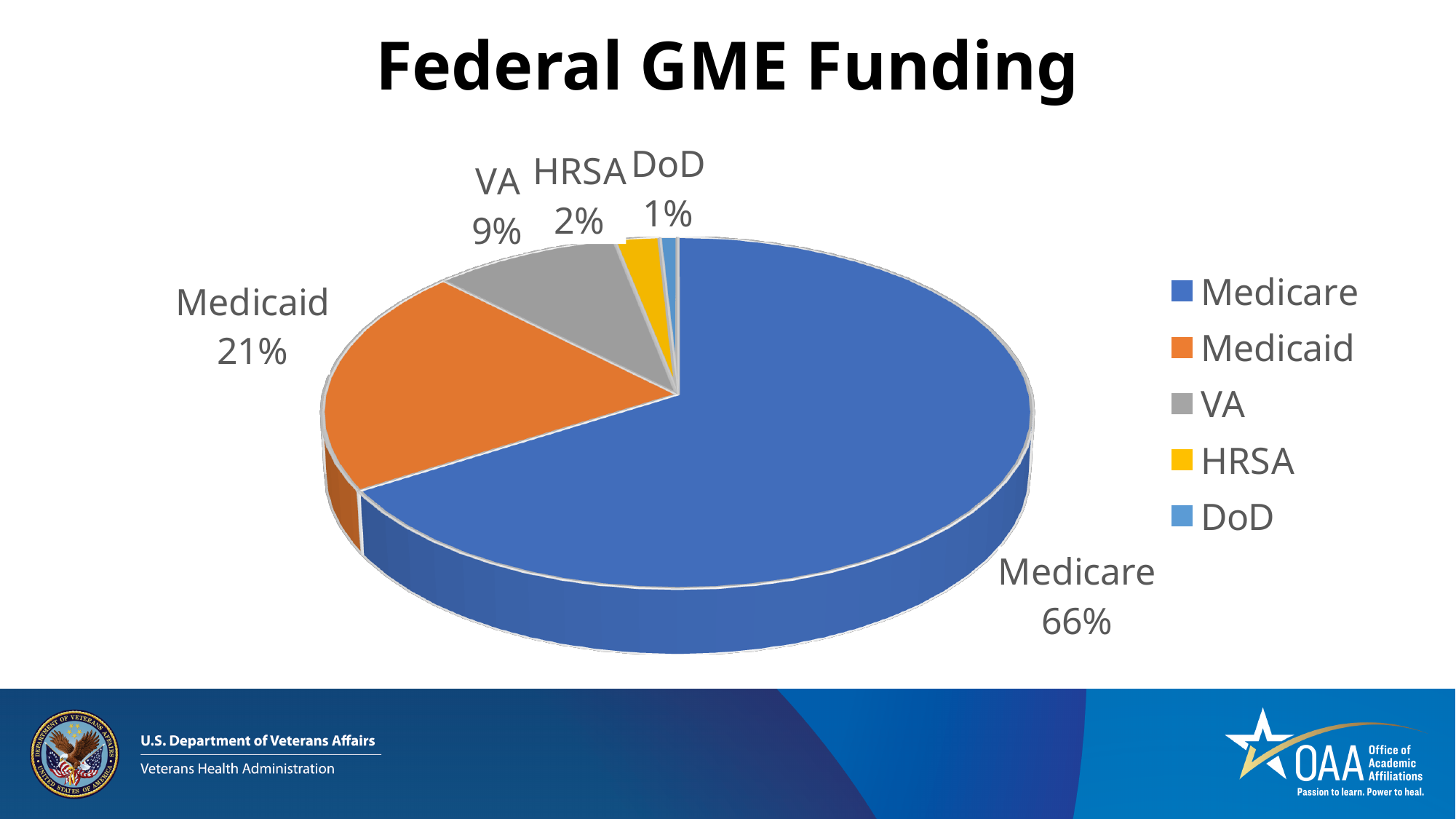
What type of chart is used to show Federal GME Funding? Pie chart Which has a larger share of Federal GME Funding, VA or HRSA? VA Which funding source has the largest share of Federal GME Funding? Medicare What is the difference in percentage points between the Medicare and Medicaid shares? 45 What share of Federal GME Funding comes from Medicaid? 21% Which funding source has the smallest share of Federal GME Funding? DoD How many funding sources are shown in the pie chart? 5 What colour represents HRSA in the pie chart? Yellow What percentage of Federal GME Funding is attributed to HRSA? 2% What percentage of Federal GME Funding is attributed to DoD? 1% What share of Federal GME Funding comes from Medicare? 66% What percentage of Federal GME Funding is attributed to the VA? 9%